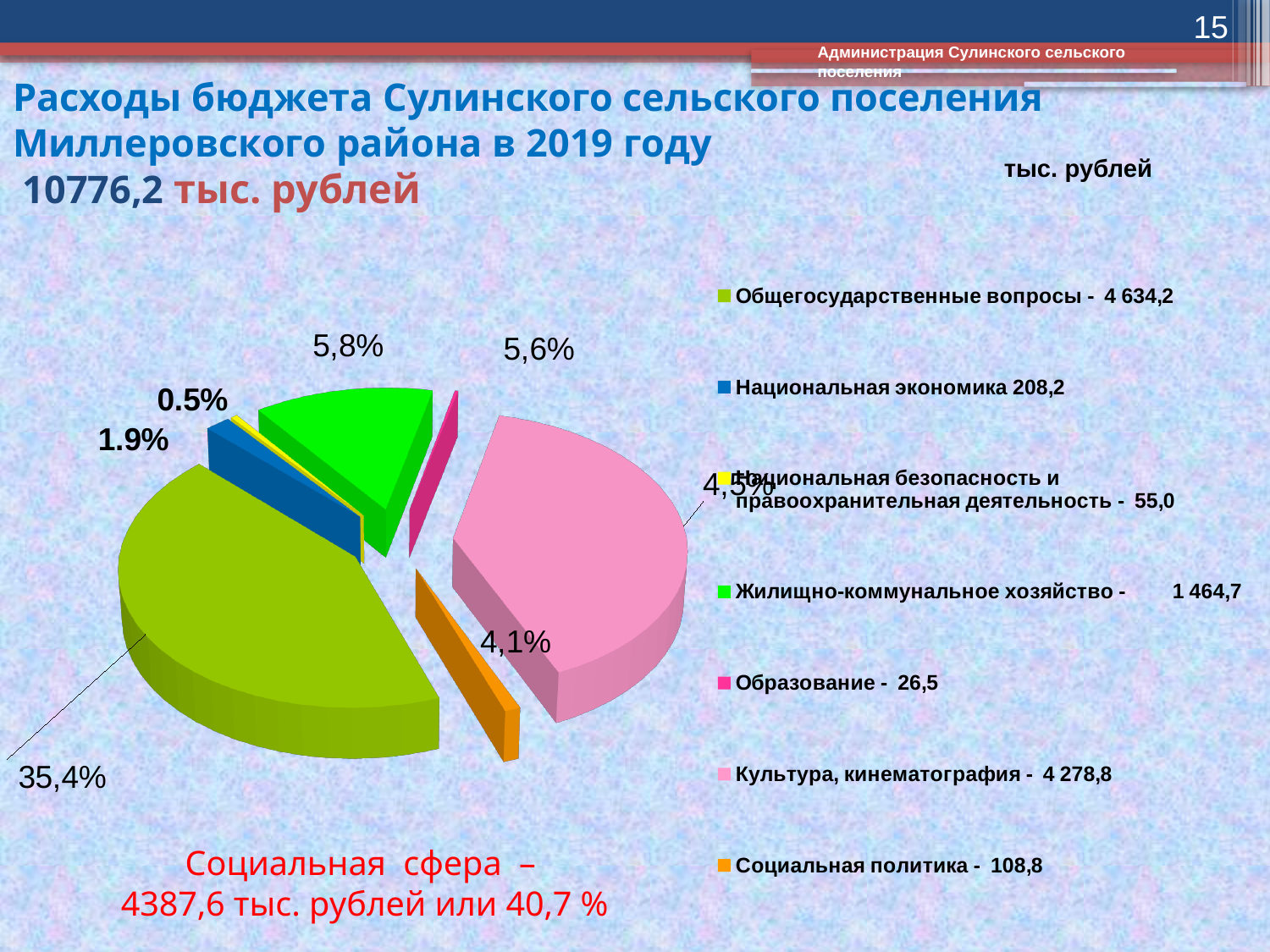
Which is larger: the value for Национальная экономика or for Жилищно-коммунальное хозяйство? Жилищно-коммунальное хозяйство What is the difference between the values for Общегосударственные вопросы and Культура, кинематография? 355,4 What kind of chart is shown on the slide? pie chart What total budget expenditure amount is stated in the slide title? 10776,2 тыс. рублей Which category has the largest value in the legend? Общегосударственные вопросы What is the value shown in the legend for Культура, кинематография? 4 278,8 What is the value shown in the legend for Социальная политика? 108,8 Which category has the smallest value in the legend? Образование What is the value shown in the legend for Общегосударственные вопросы? 4 634,2 What is the value shown in the legend for Образование? 26,5 How many categories does the legend of the pie chart list? 7 What is the value shown in the legend for Жилищно-коммунальное хозяйство? 1 464,7